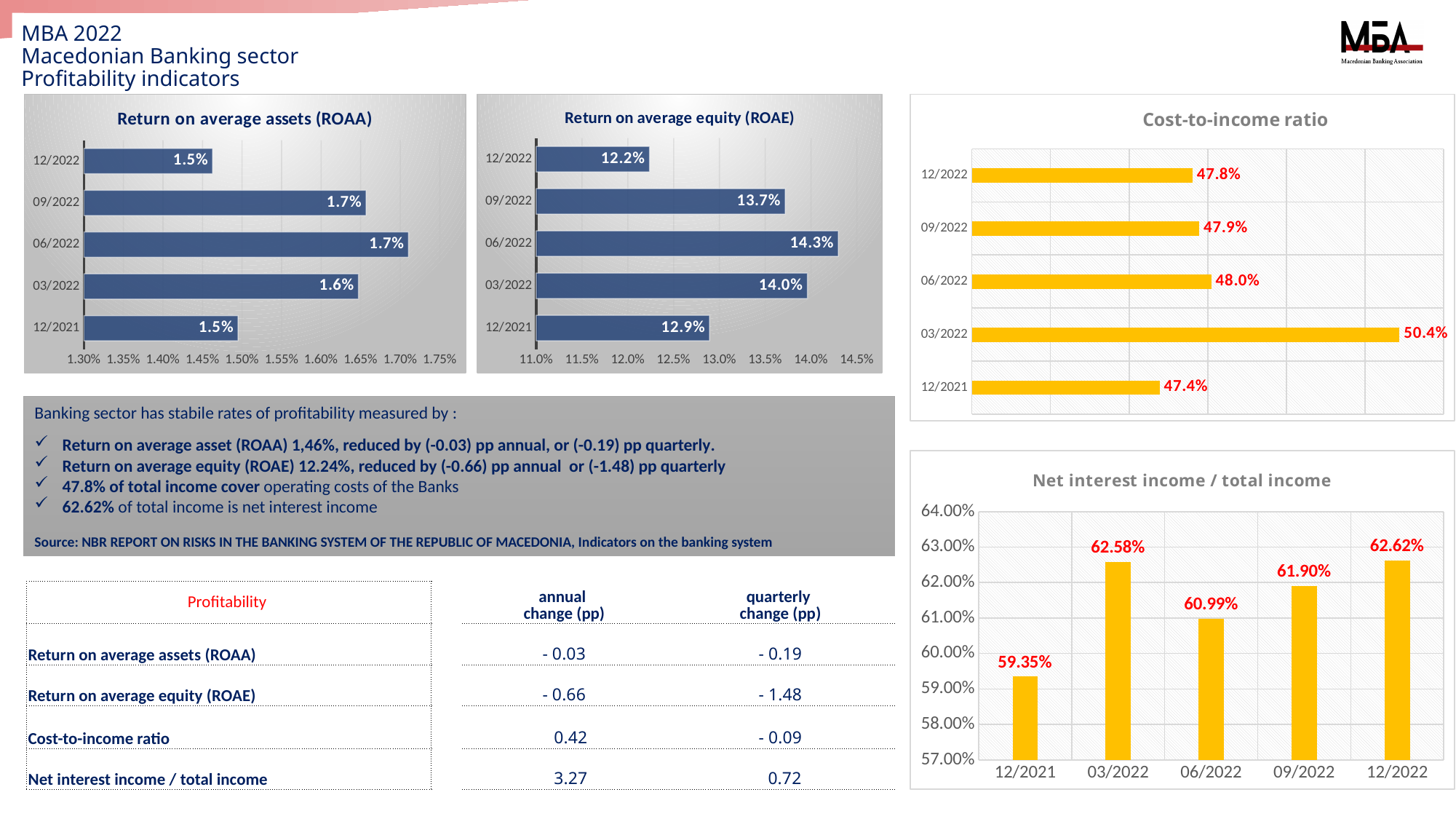
In the Net interest income / total income chart, is the value for 09/2022 larger or smaller than the value for 06/2022? larger In the Return on average equity (ROAE) chart, what is the value for 06/2022? 14.3% In the Return on average equity (ROAE) chart, which period has the lowest value? 12/2022 In the Net interest income / total income chart, which period has the lowest value? 12/2021 In the Cost-to-income ratio chart, what is the value for 03/2022? 50.4% In the Cost-to-income ratio chart, what is the difference between the 03/2022 and 12/2022 values? 2.6% In the Return on average assets (ROAA) chart, how many periods are shown? 5 In the Net interest income / total income chart, what is the value for 12/2021? 59.35% In the Cost-to-income ratio chart, which period has the lowest value? 12/2021 What type of chart is the Net interest income / total income chart? bar chart In the Return on average assets (ROAA) chart, what is the value for 03/2022? 1.6% In the Return on average equity (ROAE) chart, which period has the highest value? 06/2022